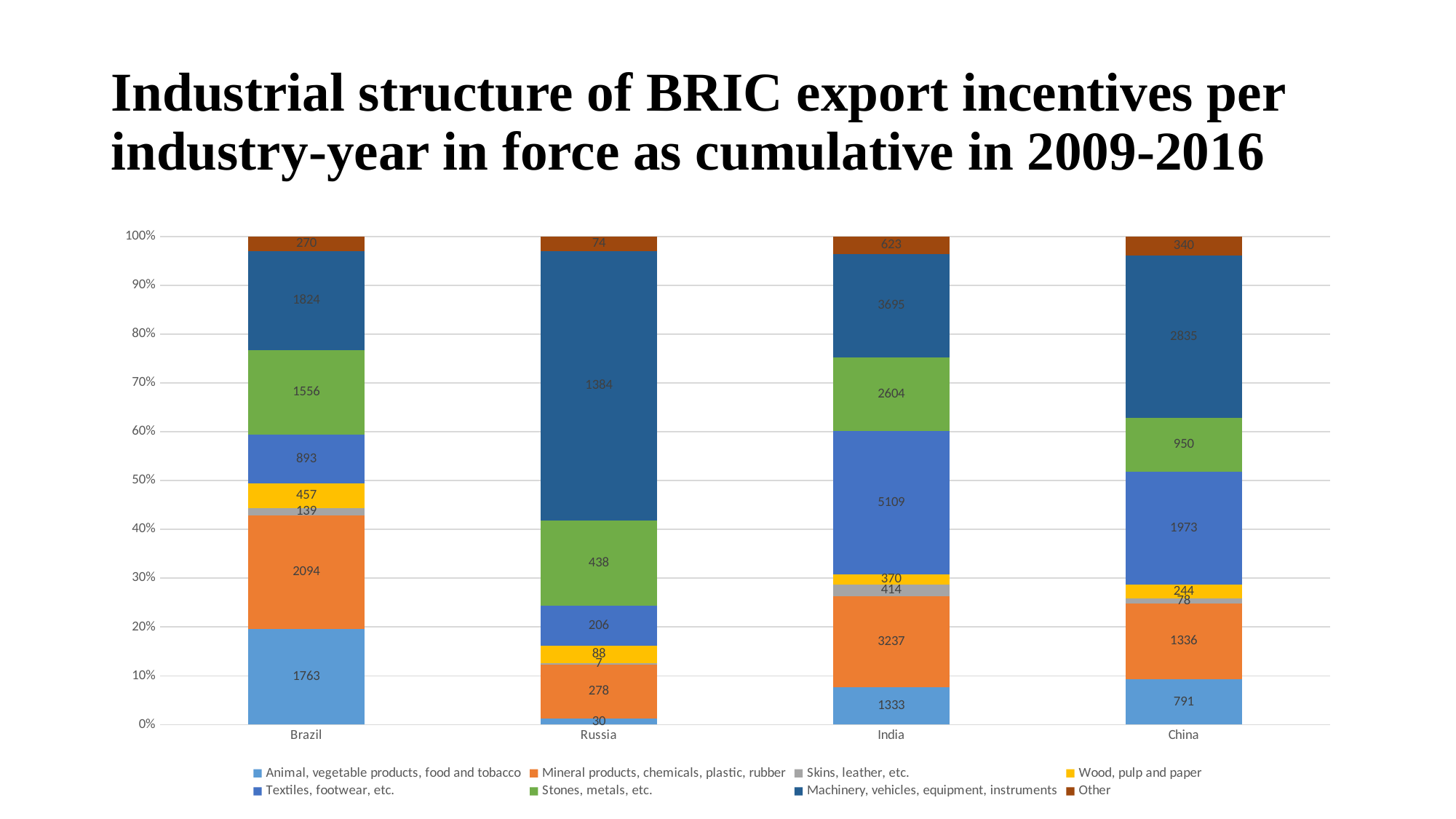
What is the value for Machinery, vehicles, equipment, instruments for India? 3695 Which country has the highest value for Textiles, footwear, etc.? India What is the value for Textiles, footwear, etc. for China? 1973 What is the total of all segments in the Russia bar? 2505 What is the value for Skins, leather, etc. for Russia? 7 What is the difference between the Stones, metals, etc. values for India and China? 1654 How many series does the legend list? 8 Which country has the lowest value for Animal, vegetable products, food and tobacco? Russia What kind of chart is this? Stacked bar chart Which is larger: the Other value for India or the Other value for China? India What is the value for Mineral products, chemicals, plastic, rubber for Brazil? 2094 How many countries are shown on the x axis? 4